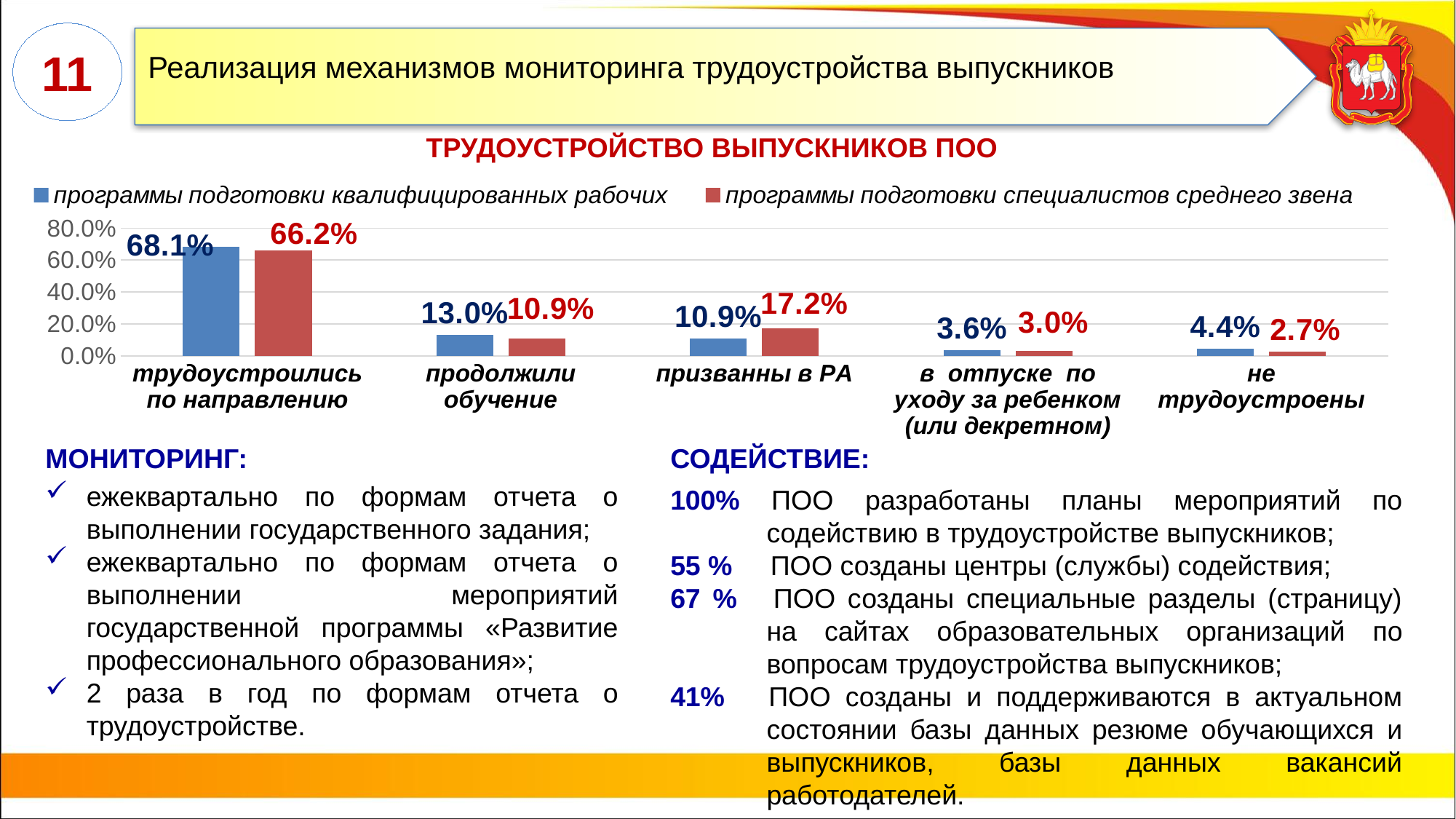
What is the difference between the two series in the category «призванны в РА»? 6.3% What is the value for «программы подготовки специалистов среднего звена» in the category «призванны в РА»? 17.2% What is the title of the chart? ТРУДОУСТРОЙСТВО ВЫПУСКНИКОВ ПОО What is the value for «программы подготовки специалистов среднего звена» in the category «не трудоустроены»? 2.7% Is the value for «программы подготовки специалистов среднего звена» in «трудоустроились по направлению» greater or less than 60.0%? greater How many categories are shown on the x axis of the chart? 5 What kind of chart is shown on the slide? bar chart What is the value for «программы подготовки квалифицированных рабочих» in the category «трудоустроились по направлению»? 68.1% In the category «продолжили обучение», which series has the larger value? программы подготовки квалифицированных рабочих Which category has the highest value for «программы подготовки квалифицированных рабочих»? трудоустроились по направлению Which category has the lowest value for «программы подготовки специалистов среднего звена»? не трудоустроены How many series does the chart legend list? 2